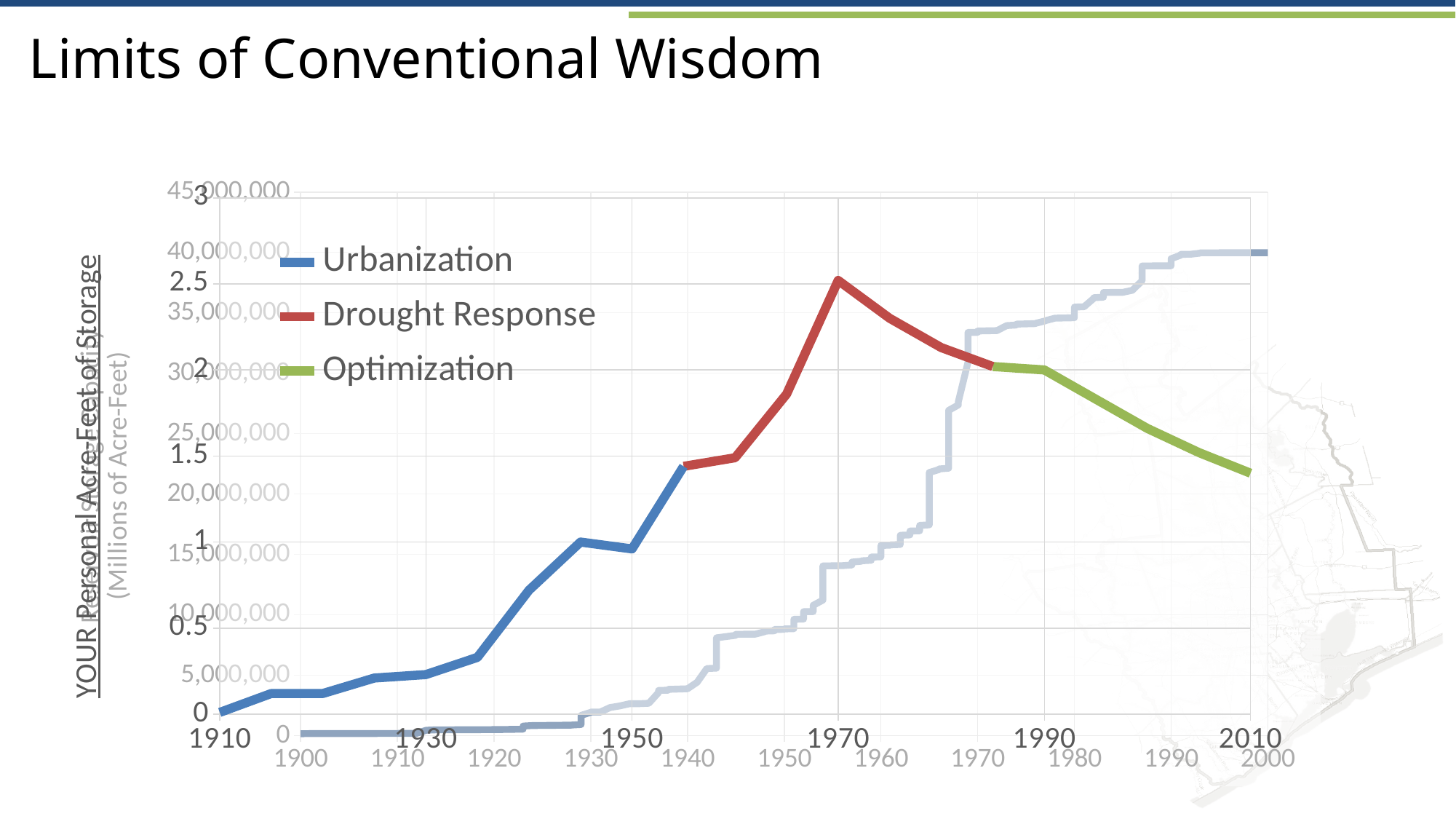
Is the peak value of the Drought Response line greater or less than 2? greater Is the Optimization value at 2010 greater or less than 1? greater What are the three series named in the legend? Urbanization, Drought Response, Optimization Around which year on the x axis does the Drought Response line reach its peak? 1970 Which series is drawn in red? Drought Response Is the Urbanization value at 1910 greater or less than 0.5? less What kind of chart is shown on the slide? line chart Does the Optimization line rise or fall from 1990 to 2010? fall Which series reaches the highest value on the chart? Drought Response Does the Urbanization line generally rise or fall from 1910 to the 1950s? rise How many series does the legend list? 3